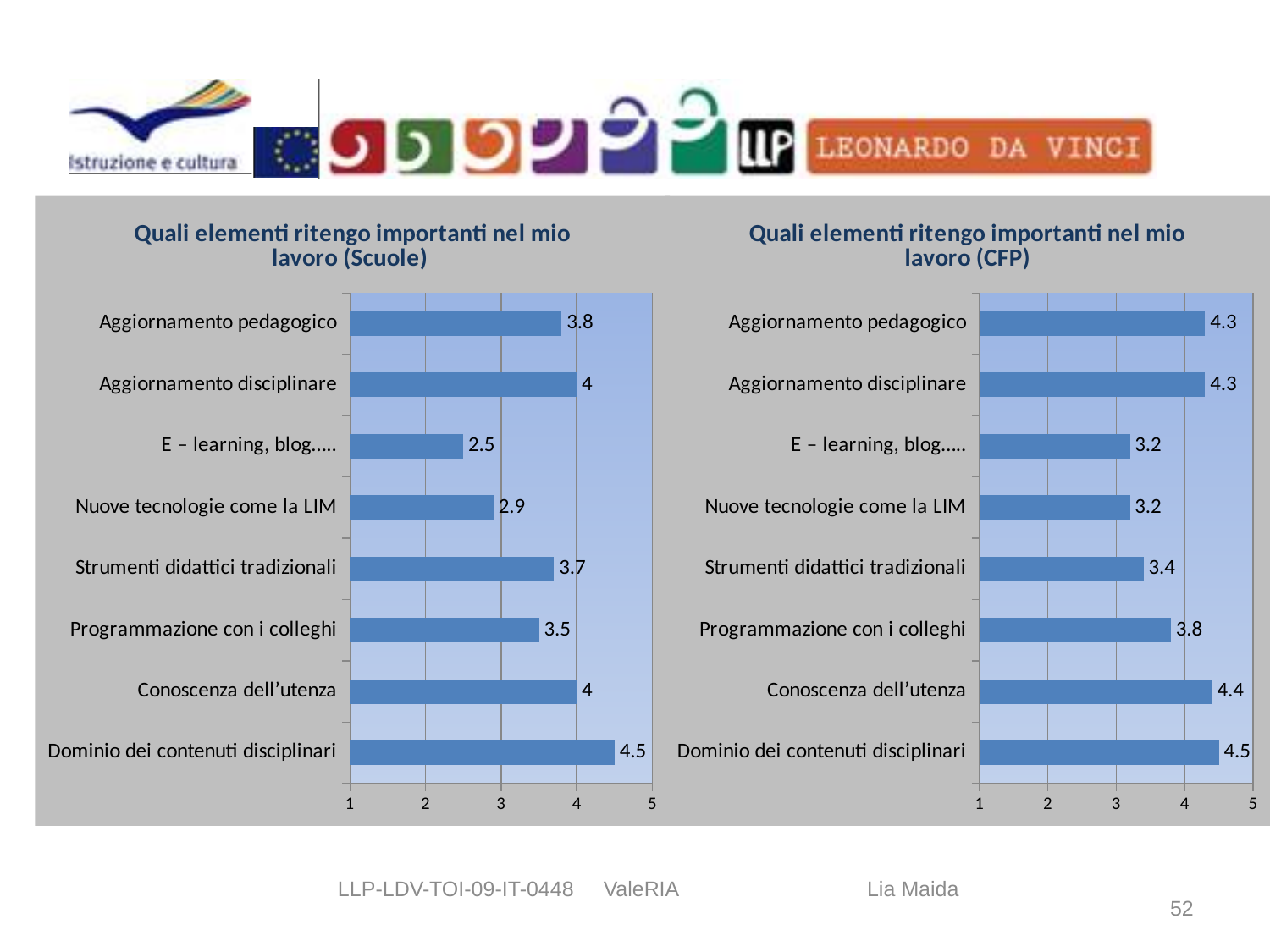
In the right chart (CFP), what is the difference between 'Conoscenza dell’utenza' and 'Strumenti didattici tradizionali'? 1 In the right chart (CFP), which category has the highest value? Dominio dei contenuti disciplinari How many categories are shown in the chart titled 'Quali elementi ritengo importanti nel mio lavoro (CFP)'? 8 In the left chart (Scuole), which category has the highest value? Dominio dei contenuti disciplinari In the left chart (Scuole), which is larger: 'Aggiornamento pedagogico' or 'Programmazione con i colleghi'? Aggiornamento pedagogico What type of chart is the left chart (Scuole)? Bar chart In the chart titled 'Quali elementi ritengo importanti nel mio lavoro (CFP)', what is the value for 'Programmazione con i colleghi'? 3.8 In the right chart (CFP), is the value for 'Nuove tecnologie come la LIM' greater or less than 4? less In the left chart (Scuole), which category has the lowest value? E – learning, blog….. In the left chart (Scuole), what is the difference between 'Dominio dei contenuti disciplinari' and 'Nuove tecnologie come la LIM'? 1.6 In the chart titled 'Quali elementi ritengo importanti nel mio lavoro (Scuole)', what is the value for 'E – learning, blog…..'? 2.5 In the right chart (CFP), what is the value for 'Aggiornamento disciplinare'? 4.3